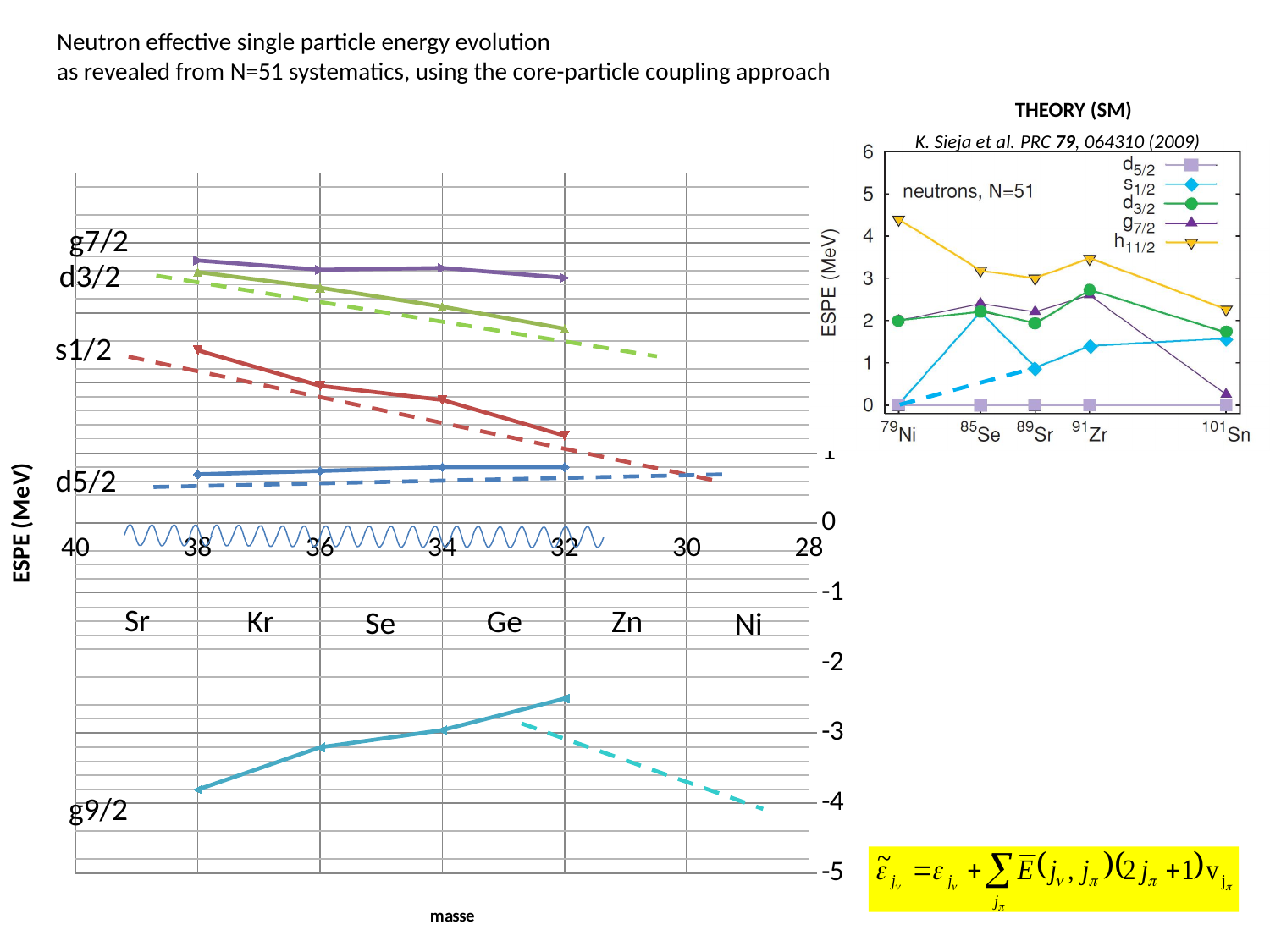
In the THEORY (SM) chart on the right, which series has the highest value at 79Ni? h11/2 In the large chart on the left, does the solid g9/2 line rise or fall going from mass 38 to mass 32? rise In the large chart on the left, is the value of the g9/2 line at mass 38 greater or less than -3? less In the THEORY (SM) chart on the right, how many series does the legend list? 5 In the THEORY (SM) chart on the right, is the h11/2 value at 79Ni greater or less than 4? greater In the large chart on the left, which orbital line lies highest on the plot? g7/2 In the large chart on the left, is the value of the g9/2 line at mass 32 greater or less than -3? greater In the large chart on the left, what is the label of the x axis? masse In the THEORY (SM) chart on the right, how many nuclei are labelled on the x axis? 5 In the large chart on the left, what kind of chart is it? line chart In the large chart on the left, does the solid s1/2 line rise or fall going from mass 38 to mass 32? fall In the large chart on the left, which orbital line lies lowest on the plot? g9/2